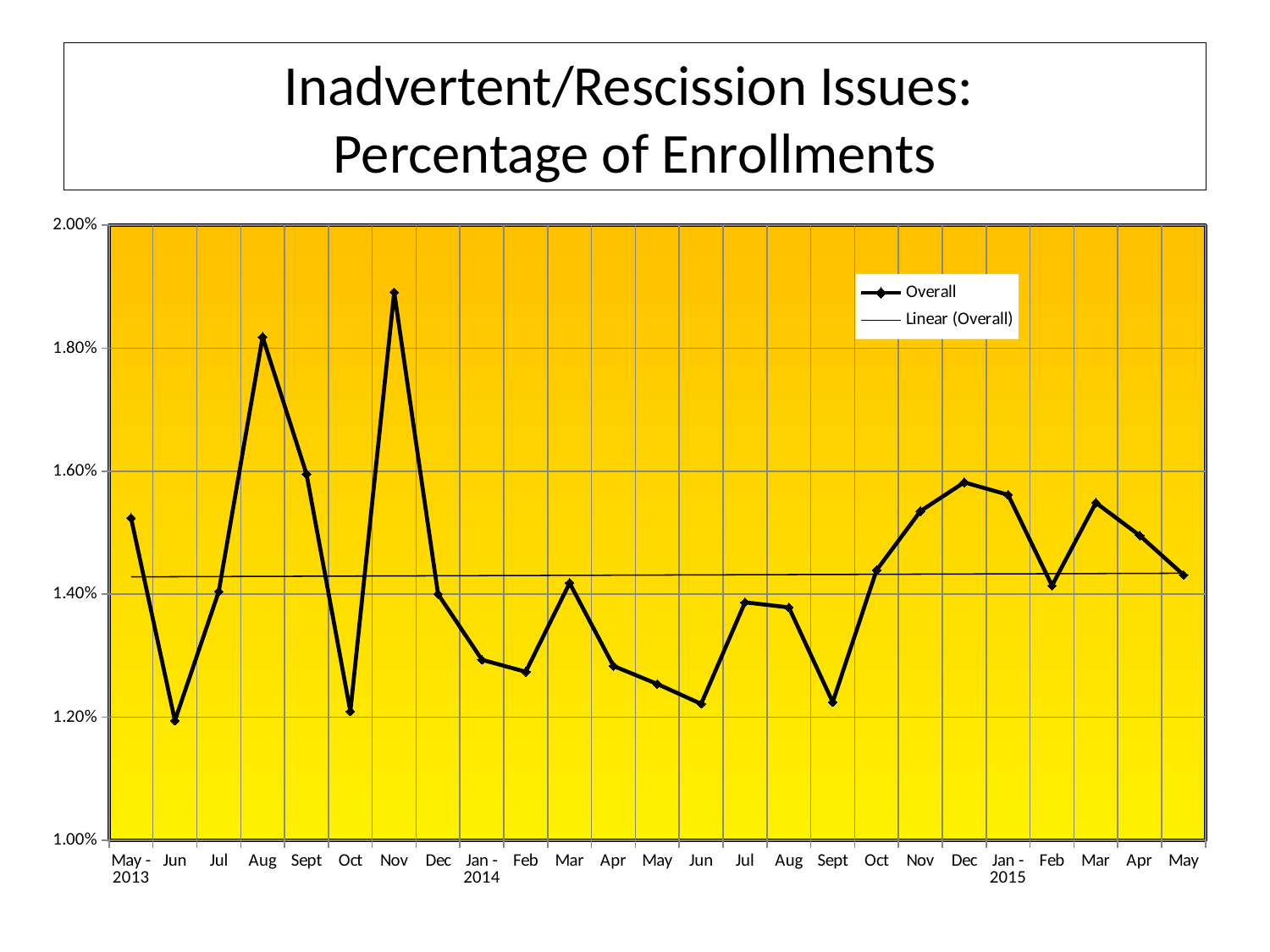
Which has the higher Overall value, Aug 2013 or Nov 2013? Nov 2013 What kind of chart is shown on the slide? Line chart What is the title of the chart? Inadvertent/Rescission Issues: Percentage of Enrollments What are the two entries in the legend? Overall and Linear (Overall) Is the Overall value for Sept 2014 greater or less than 1.40%? less In which month does the Overall line reach its highest value? Nov (2013) Is the Overall value for Nov 2013 greater or less than 1.80%? greater Is the Overall value for Dec 2014 greater or less than 1.40%? greater Does the Overall line rise or fall from Sept 2014 to Dec 2014? Rise How many entries does the legend list? 2 How many monthly data points are plotted on the Overall line? 25